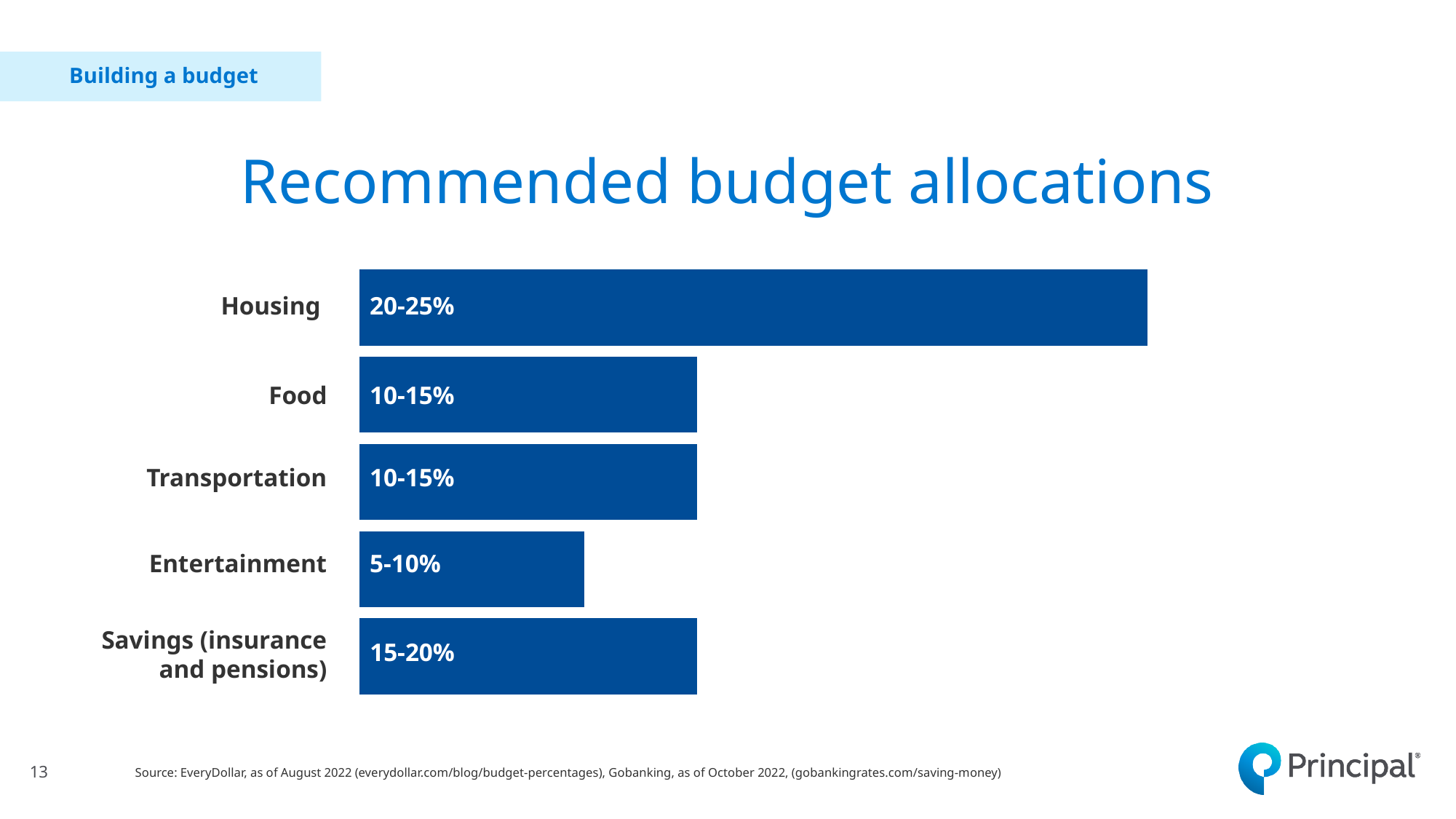
Which has a larger recommended allocation, Savings (insurance and pensions) or Entertainment? Savings (insurance and pensions) Which has a larger recommended allocation, Housing or Food? Housing What is the recommended budget allocation shown for Entertainment? 5-10% Which category has the smallest recommended budget allocation? Entertainment Which category has the largest recommended budget allocation? Housing How many budget categories are shown in the chart? 5 What is the title of the chart on the slide? Recommended budget allocations What is the recommended budget allocation shown for Transportation? 10-15% What is the recommended budget allocation shown for Savings (insurance and pensions)? 15-20% What kind of chart is used to show the recommended budget allocations? Bar chart What is the recommended budget allocation shown for Food? 10-15% What is the recommended budget allocation shown for Housing? 20-25%